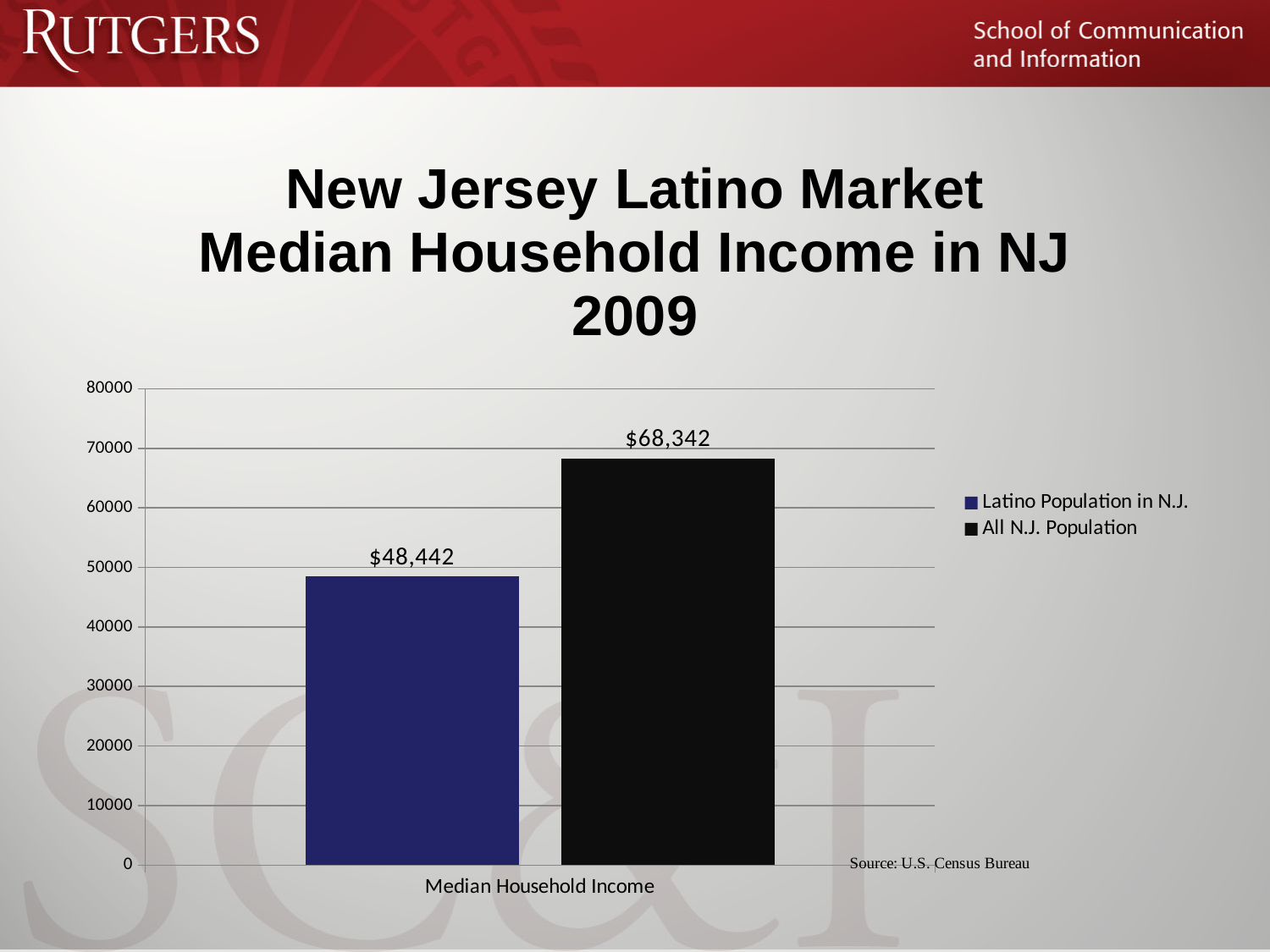
How many bars are plotted in the chart? 2 Is the median household income for the Latino Population in N.J. greater or less than 50000? less What colour is the bar for All N.J. Population? Black What kind of chart is shown on the slide? Bar chart Which series has the lower median household income? Latino Population in N.J. What is the median household income for the Latino Population in N.J.? $48,442 How many series does the legend list? 2 What is the difference between the median household income of All N.J. Population and the Latino Population in N.J.? $19,900 Which series has the higher median household income? All N.J. Population What is the label on the x axis of the chart? Median Household Income What is the median household income for All N.J. Population? $68,342 Is the median household income for All N.J. Population greater or less than 60000? greater